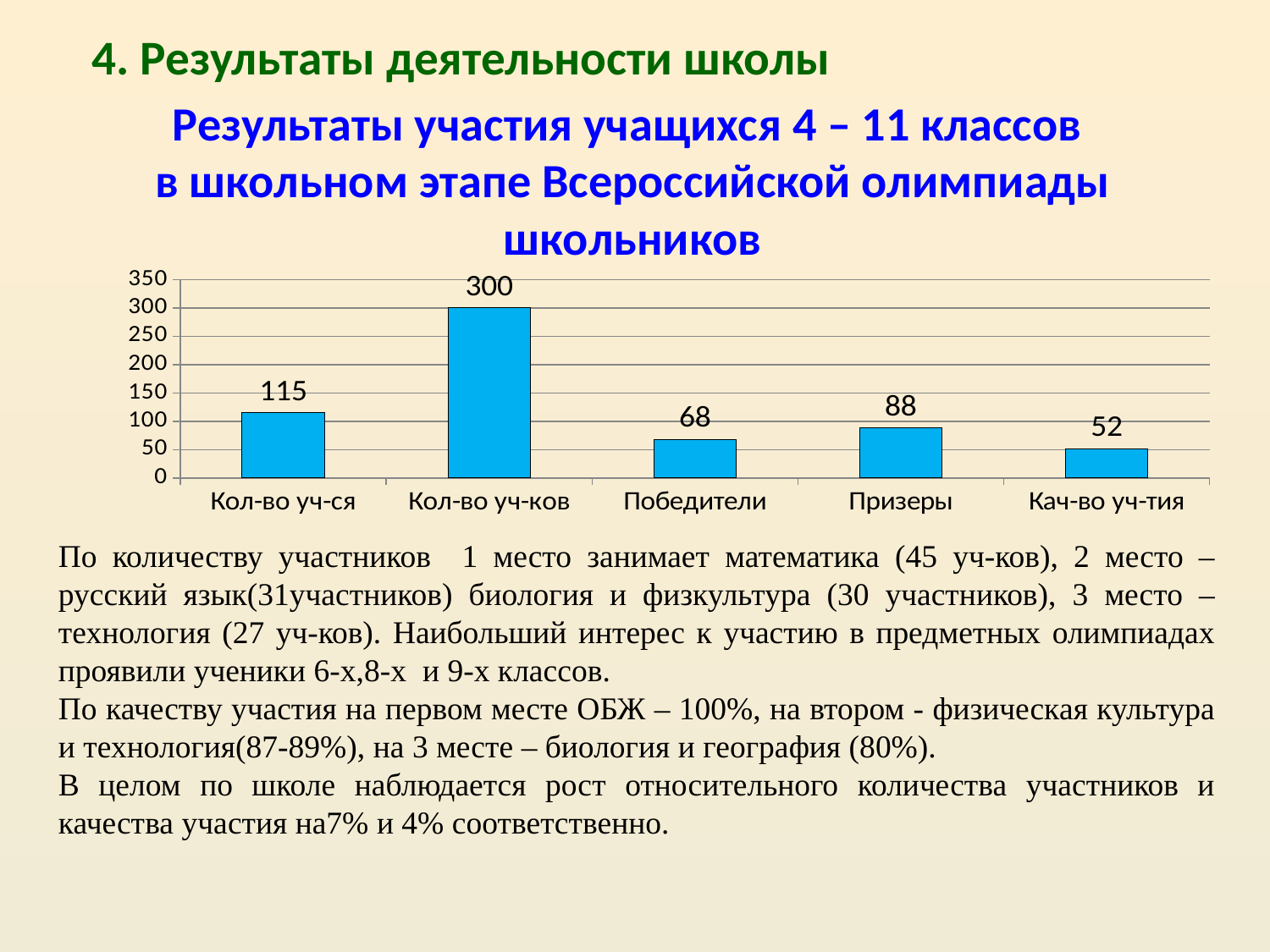
What is the difference between the values for Кол-во уч-ков and Кол-во уч-ся? 185 Which is larger, the value for Призеры or the value for Победители? Призеры Which category has the lowest value? Кач-во уч-тия What kind of chart is shown on the slide? Bar chart What is the difference between the values for Призеры and Победители? 20 What is the value for Победители? 68 What is the value for Кол-во уч-ся? 115 What is the value for Призеры? 88 What is the value for Кол-во уч-ков? 300 What is the value for Кач-во уч-тия? 52 Which category has the highest value? Кол-во уч-ков How many categories are shown on the x axis? 5